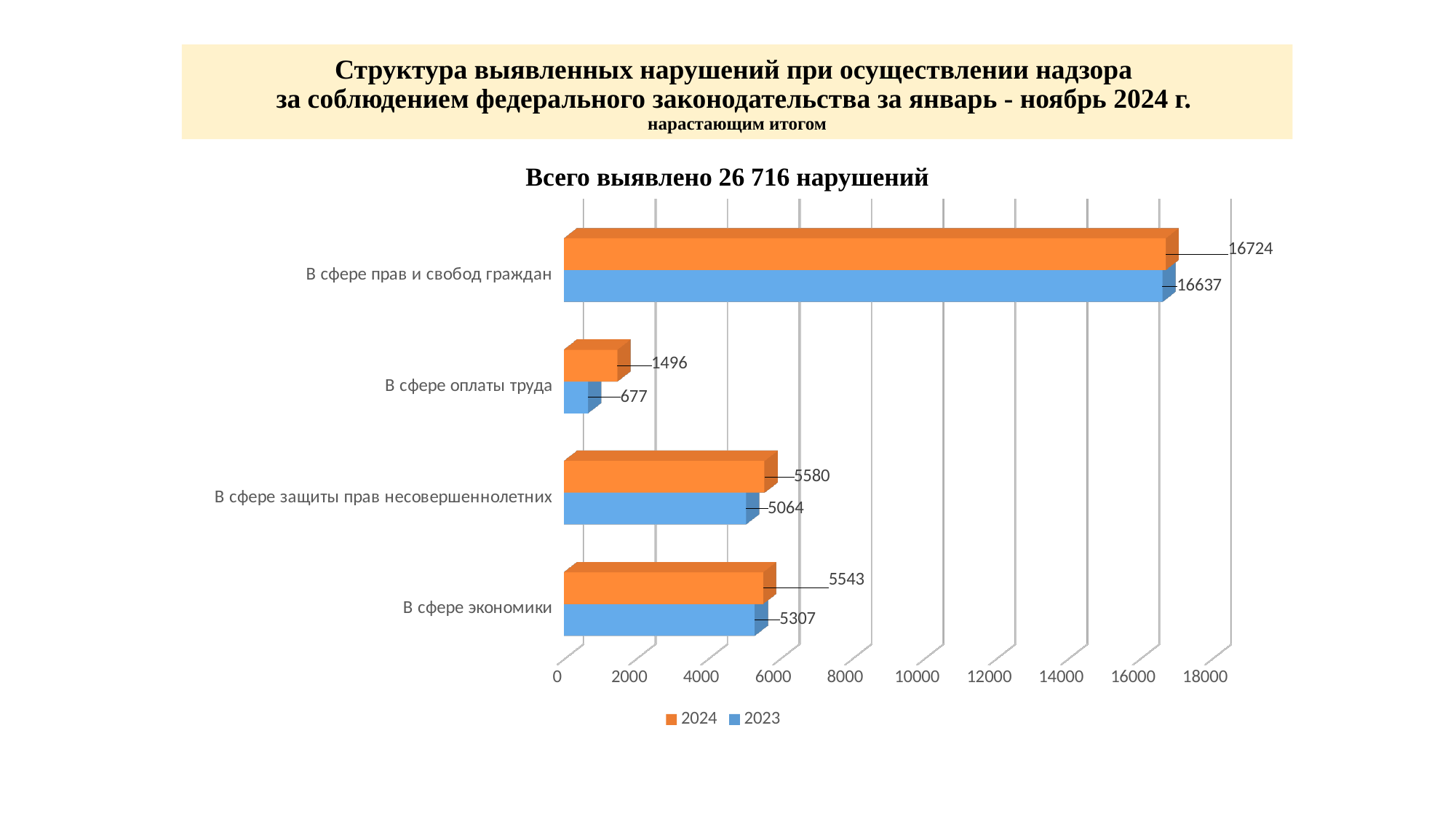
What is the 2024 value for "В сфере защиты прав несовершеннолетних"? 5580 Which is larger: the 2024 value for "В сфере экономики" or the 2024 value for "В сфере оплаты труда"? В сфере экономики What kind of chart is shown on the slide? Bar chart Which category has the highest 2024 value? В сфере прав и свобод граждан Which category has the lowest 2023 value? В сфере оплаты труда How many categories are shown on the chart? 4 What is the 2024 value for "В сфере прав и свобод граждан"? 16724 What is the difference between the 2024 and 2023 values for "В сфере прав и свобод граждан"? 87 What is the 2023 value for "В сфере экономики"? 5307 How many series does the legend list? 2 What is the 2023 value for "В сфере оплаты труда"? 677 What is the difference between the 2024 and 2023 values for "В сфере оплаты труда"? 819